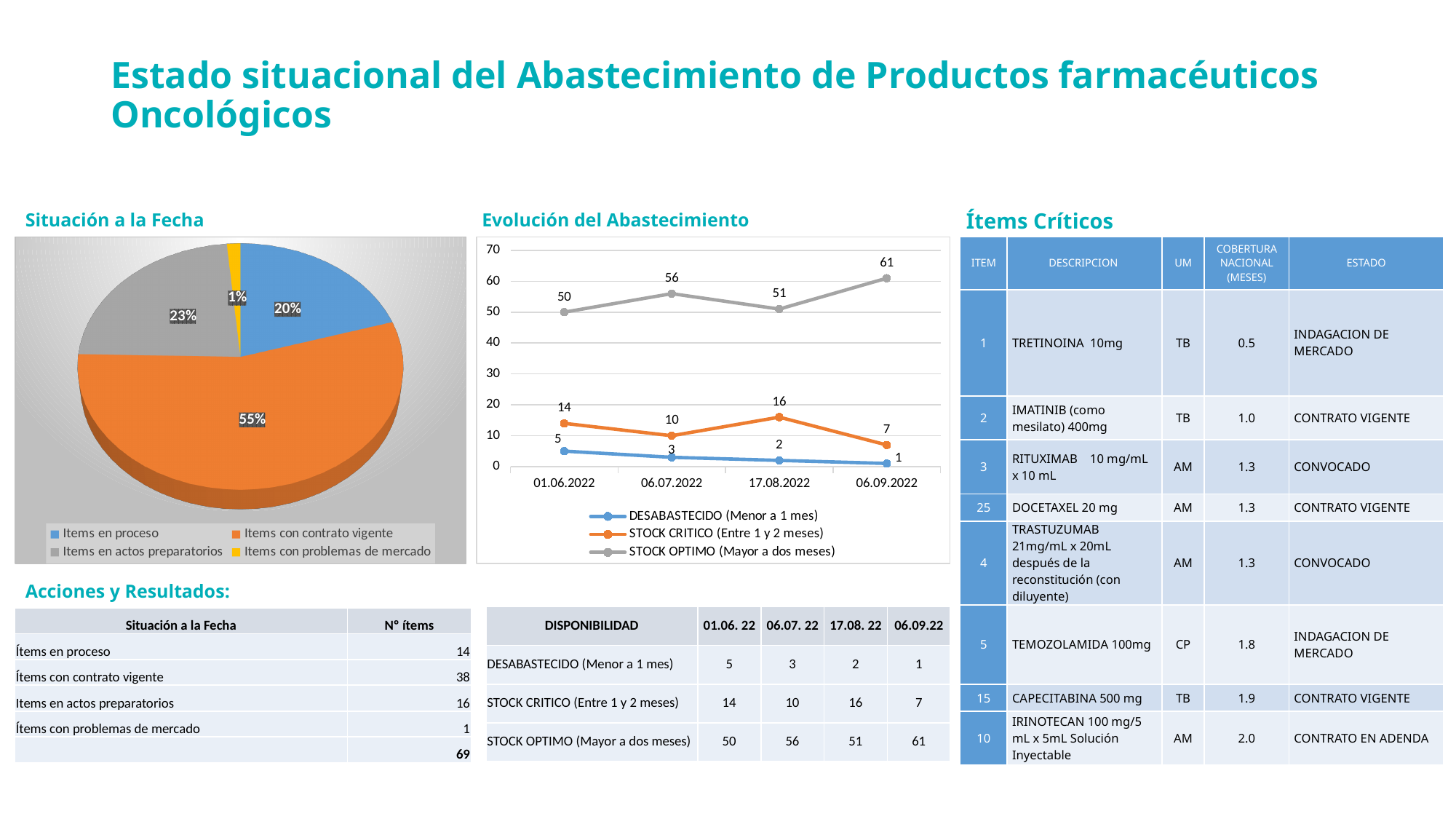
In the 'Evolución del Abastecimiento' chart, what is the value of STOCK CRITICO (Entre 1 y 2 meses) on 17.08.2022? 16 What kind of chart is 'Evolución del Abastecimiento'? Line chart How many categories does the legend of the 'Situación a la Fecha' pie chart list? 4 In the 'Situación a la Fecha' pie chart, what share is shown for 'Items con contrato vigente'? 55% In the 'Evolución del Abastecimiento' chart, what is the difference between STOCK OPTIMO and STOCK CRITICO on 06.07.2022? 46 In the 'Evolución del Abastecimiento' chart, does the DESABASTECIDO (Menor a 1 mes) series rise or fall from 01.06.2022 to 06.09.2022? Fall In the 'Situación a la Fecha' pie chart, which category has the largest slice? Items con contrato vigente In the 'Situación a la Fecha' pie chart, which category has the smallest slice? Items con problemas de mercado In the 'Situación a la Fecha' pie chart, what share is shown for 'Items en actos preparatorios'? 23% In the 'Evolución del Abastecimiento' chart, what is the value of STOCK OPTIMO (Mayor a dos meses) on 06.09.2022? 61 In the 'Evolución del Abastecimiento' chart, which is larger on 01.06.2022: STOCK CRITICO or DESABASTECIDO? STOCK CRITICO In the 'Evolución del Abastecimiento' chart, how many series does the legend list? 3